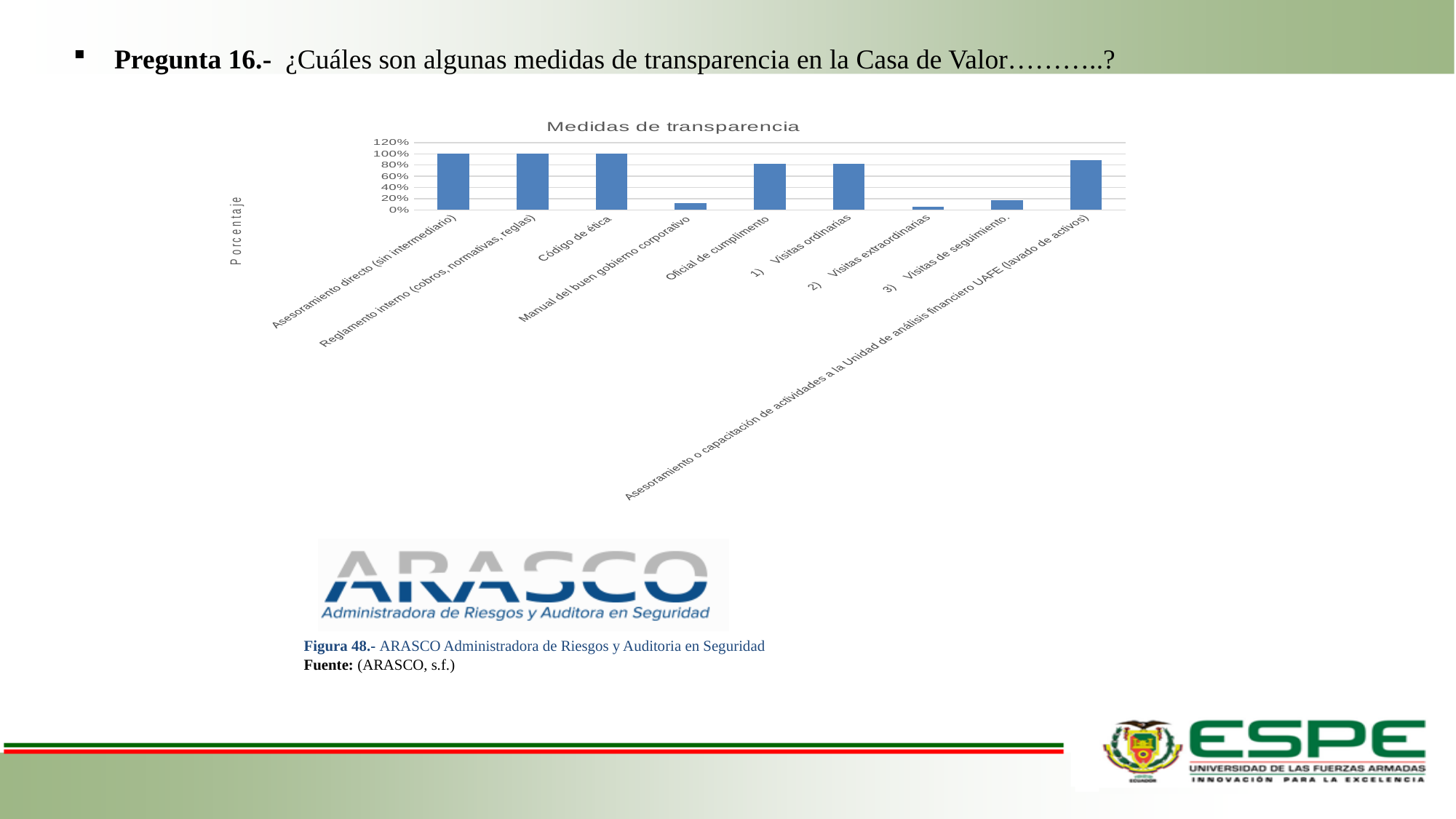
What is the title of the chart? Medidas de transparencia Is the value for Manual del buen gobierno corporativo greater or less than 20%? less Is the value for Oficial de cumplimiento greater or less than 60%? greater Is the value for 3) Visitas de seguimiento greater or less than 40%? less What is the value for Código de ética? 100% Which is larger, the value for Código de ética or the value for 3) Visitas de seguimiento? Código de ética What is the value for Asesoramiento directo (sin intermediario)? 100% What is the label on the vertical axis of the chart? Porcentaje How many categories are plotted in the chart? 9 Which is larger, the value for 1) Visitas ordinarias or the value for 2) Visitas extraordinarias? 1) Visitas ordinarias Which category has the lowest value? 2) Visitas extraordinarias What kind of chart is shown on the slide? bar chart